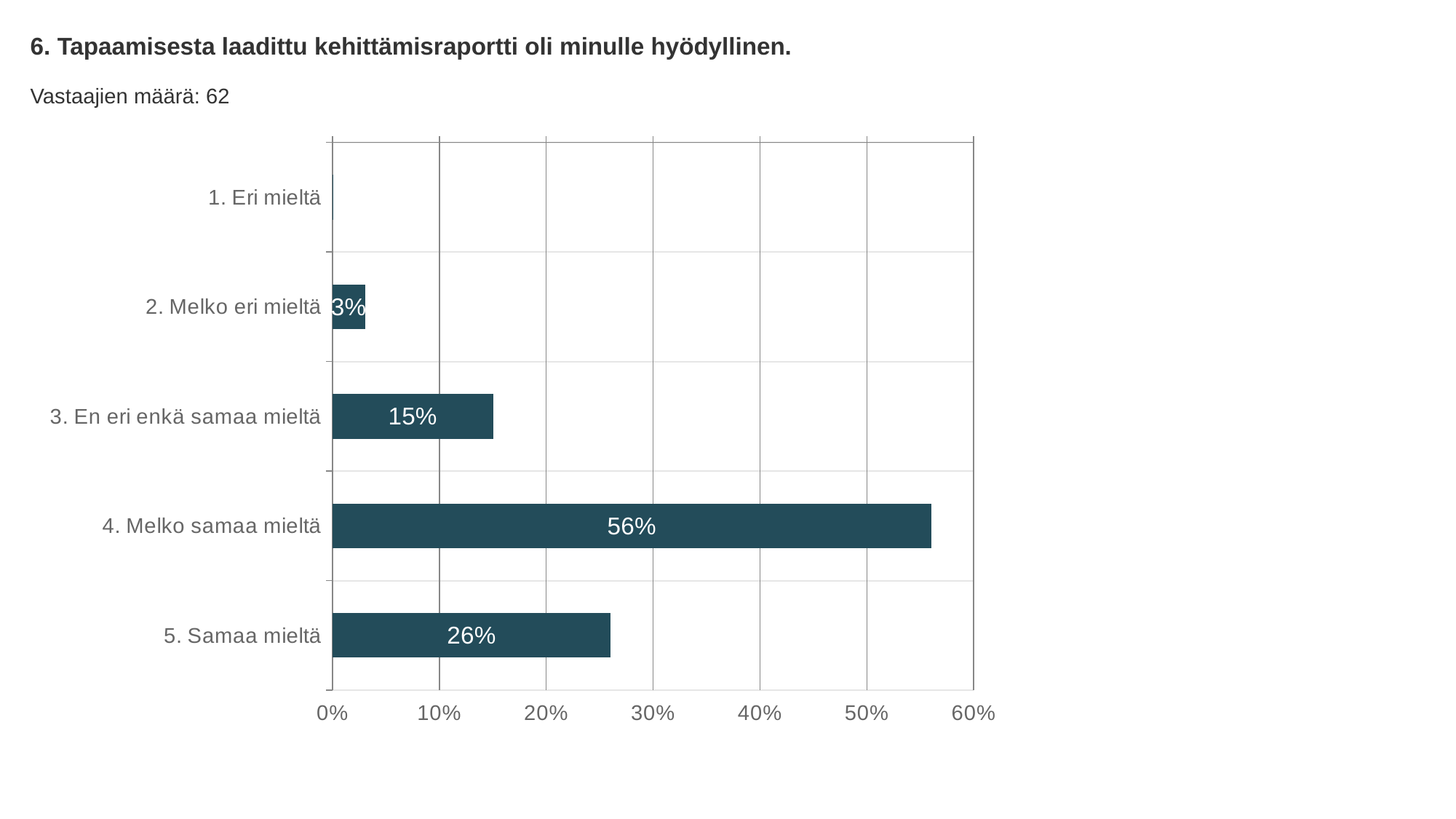
What is the value shown for "5. Samaa mieltä"? 26% What is the highest value shown on the x axis? 60% How many categories are shown on the chart? 5 What is the value shown for "3. En eri enkä samaa mieltä"? 15% What percentage of respondents chose "4. Melko samaa mieltä"? 56% Which category has the highest value? 4. Melko samaa mieltä What is the value shown for "2. Melko eri mieltä"? 3% What kind of chart is shown on the slide? bar chart How many respondents (Vastaajien määrä) are reported on the slide? 62 What is the difference between the values for "4. Melko samaa mieltä" and "5. Samaa mieltä"? 30% Is the value for "4. Melko samaa mieltä" greater or less than 50%? greater Which is larger, the value for "5. Samaa mieltä" or the value for "3. En eri enkä samaa mieltä"? 5. Samaa mieltä